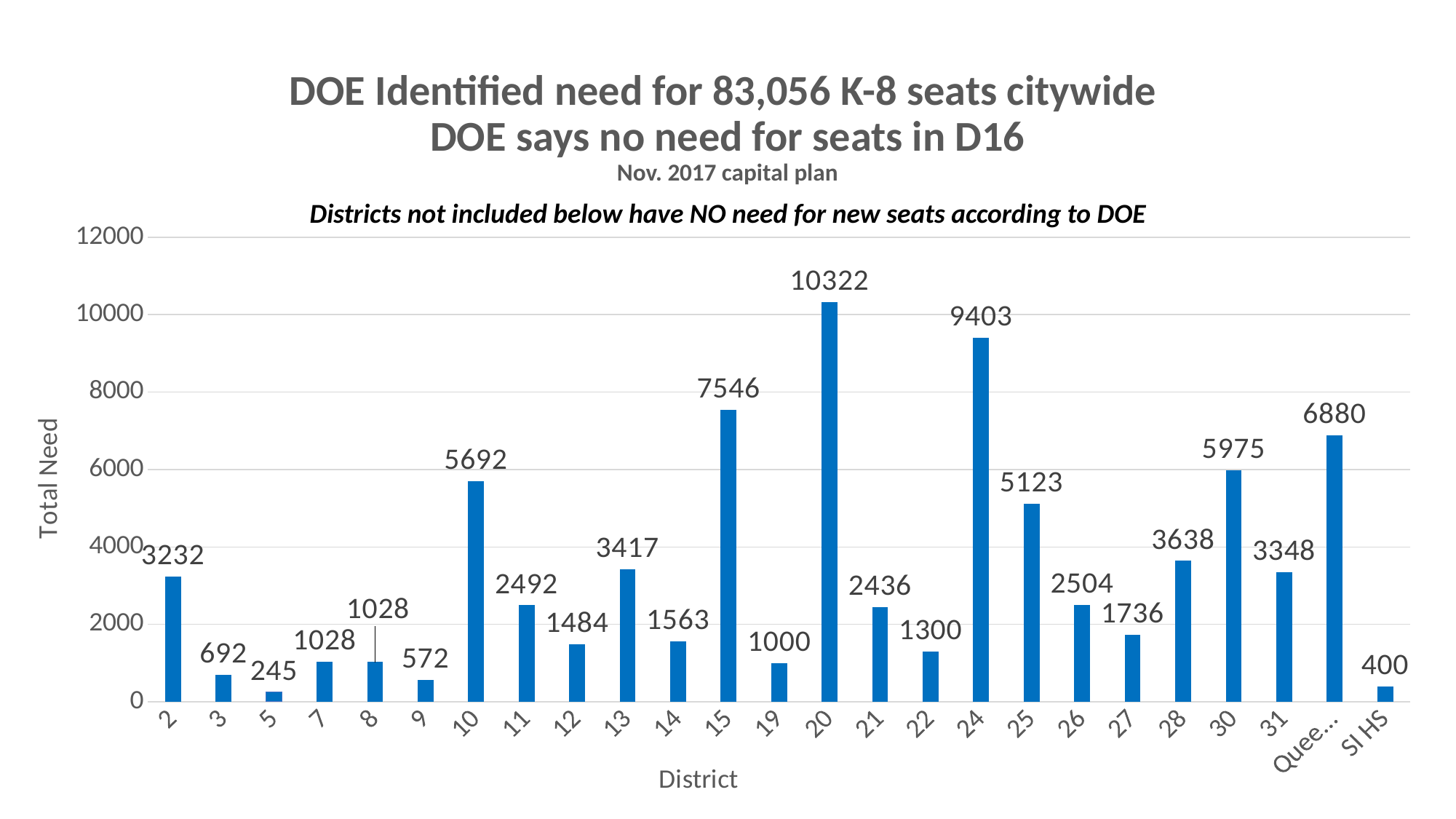
What is the total need value for district 15? 7546 What is the total need value for district 9? 572 How many districts are shown on the x axis of the chart? 25 Which district has the highest total need? 20 Which has a larger total need, district 10 or district 30? 30 What kind of chart is shown on the slide? bar chart What is the total need value for district 20? 10322 Which district has the lowest total need? 5 What is the total need value for SI HS? 400 What is the difference in total need between district 24 and district 25? 4280 Is the value for district 28 greater or less than 4000? less What is the label of the y axis? Total Need